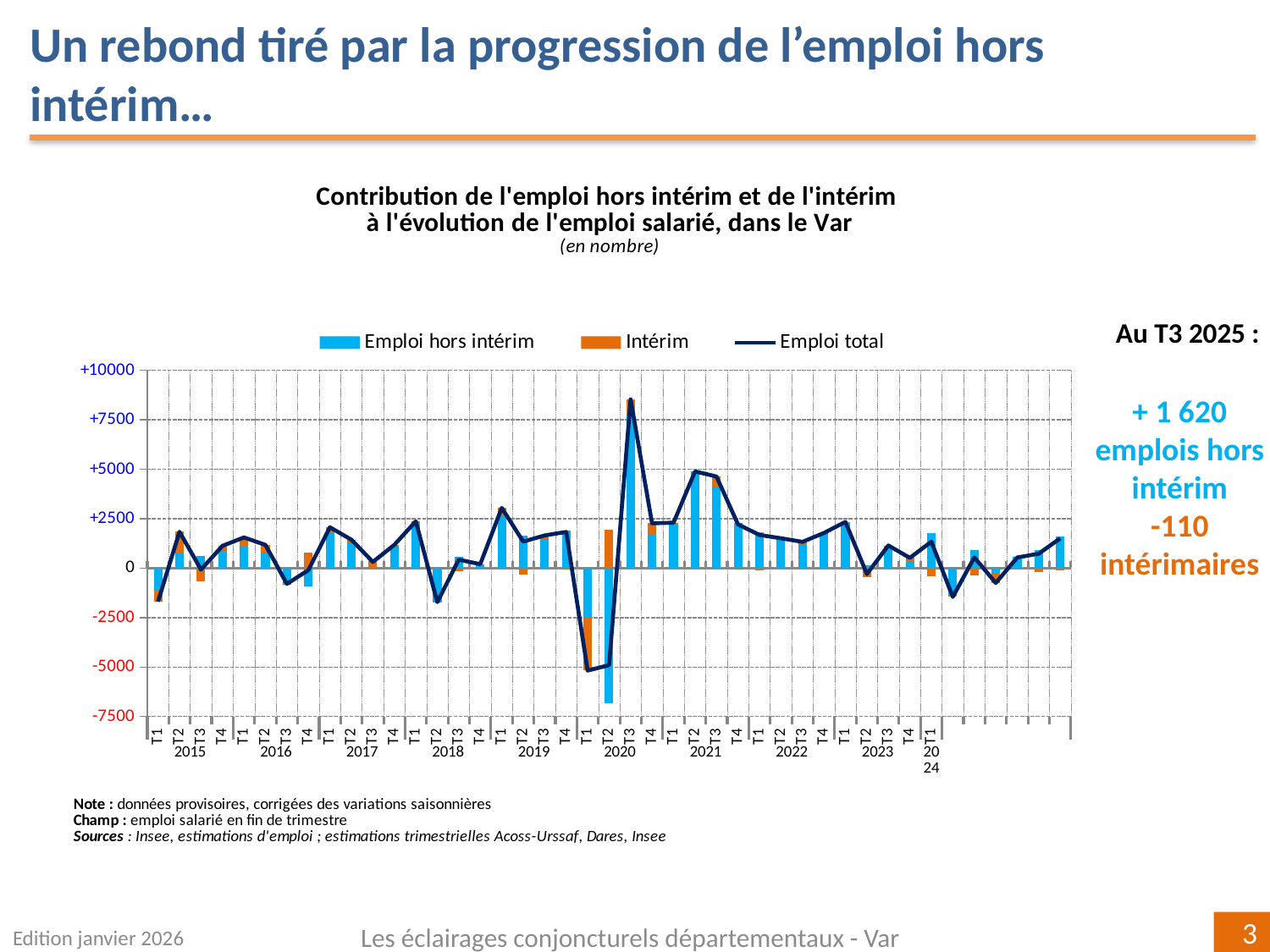
Does the 'Emploi total' line rise or fall between T1 2020 and T3 2020? rise Is the value of 'Emploi total' at T3 2020 greater or less than 7500? greater Is the value of 'Emploi total' at T2 2021 greater or less than 2500? greater Which colour represents the 'Intérim' series in the chart? Orange Which is larger, the 'Emploi total' value at T3 2020 or at T2 2021? T3 2020 In which quarter does the 'Emploi total' line reach its lowest value? T1 2020 According to the slide, what is the change in 'emplois hors intérim' at T3 2025? + 1 620 According to the slide, what is the change in 'intérimaires' at T3 2025? -110 How many series does the chart legend list? 3 Is the 'Emploi hors intérim' bar at T2 2020 greater or less than -5000? less What kind of chart is used to show the contributions of 'Emploi hors intérim' and 'Intérim'? Bar chart (with a line for Emploi total) In which quarter does the 'Emploi total' line reach its highest value? T3 2020